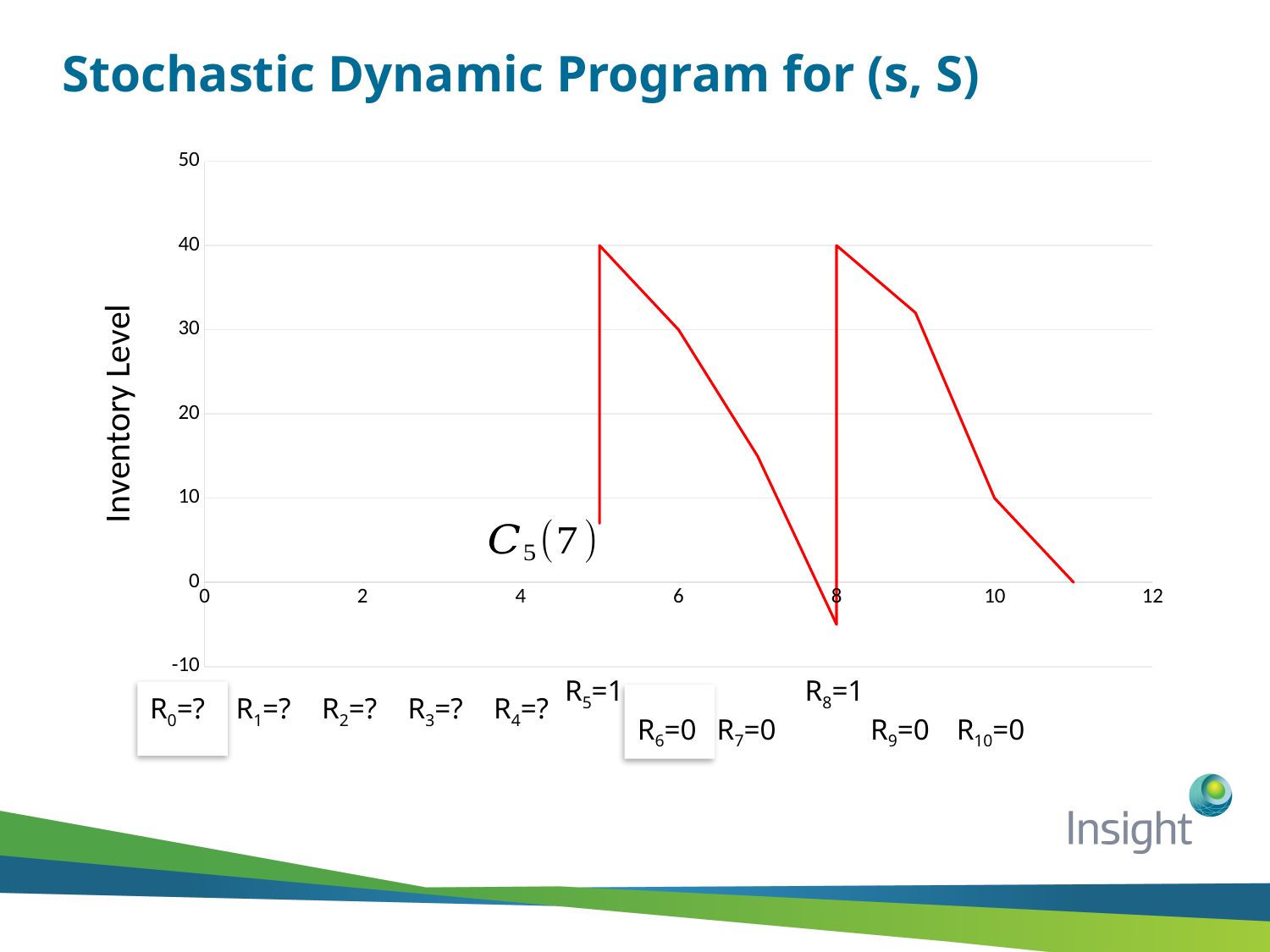
What kind of chart is shown on the slide? line chart What is the label of the vertical axis of the chart? Inventory Level Is the inventory level at x = 7 greater or less than 20? less What is the peak inventory level reached by the line at x = 5? 40 What is the peak inventory level reached by the line at x = 8? 40 Is the inventory level at x = 9 greater or less than 30? greater Is the inventory level just before the jump at x = 8 greater or less than 0? less Which is larger: the inventory level at x = 6 or at x = 10? x = 6 Between x = 5 and x = 8 (before the jump), does the inventory level rise or fall? fall Between x = 8 and x = 11, does the inventory level rise or fall? fall What is the highest value shown on the vertical axis of the chart? 50 What is the lowest value shown on the vertical axis of the chart? -10